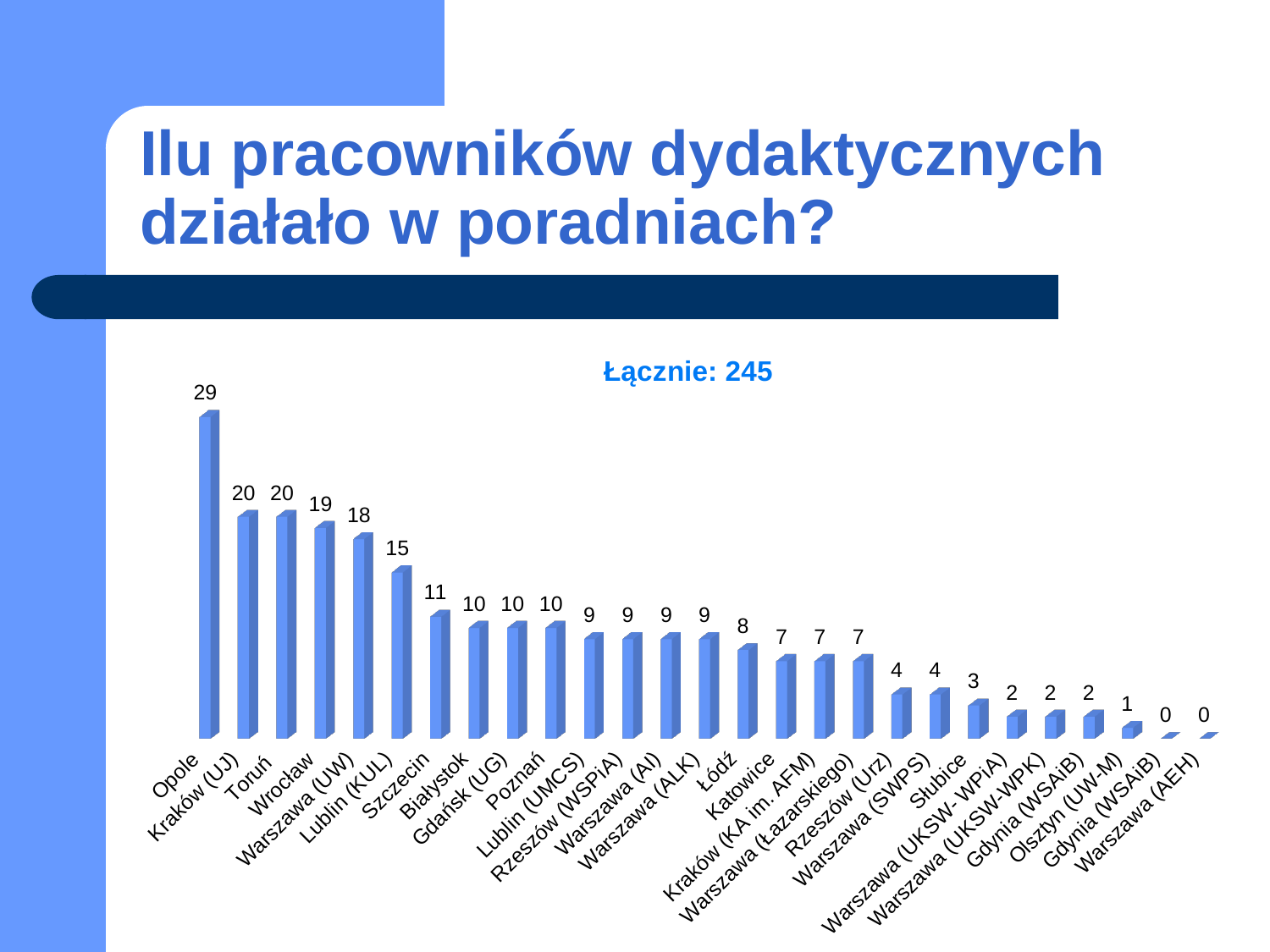
What is the difference between the values for Opole and Wrocław? 10 What is the value for Opole? 29 What is the value for Warszawa (SWPS)? 4 What is the value for Olsztyn (UW-M)? 1 What type of chart is shown on the slide? bar chart What total is stated in the text above the chart? Łącznie: 245 Which category has the highest value? Opole How many categories are shown on the x axis? 27 What is the value for Szczecin? 11 What is the difference between the values for Warszawa (UW) and Łódź? 10 What is the value for Lublin (KUL)? 15 Which is larger, the value for Toruń or the value for Katowice? Toruń